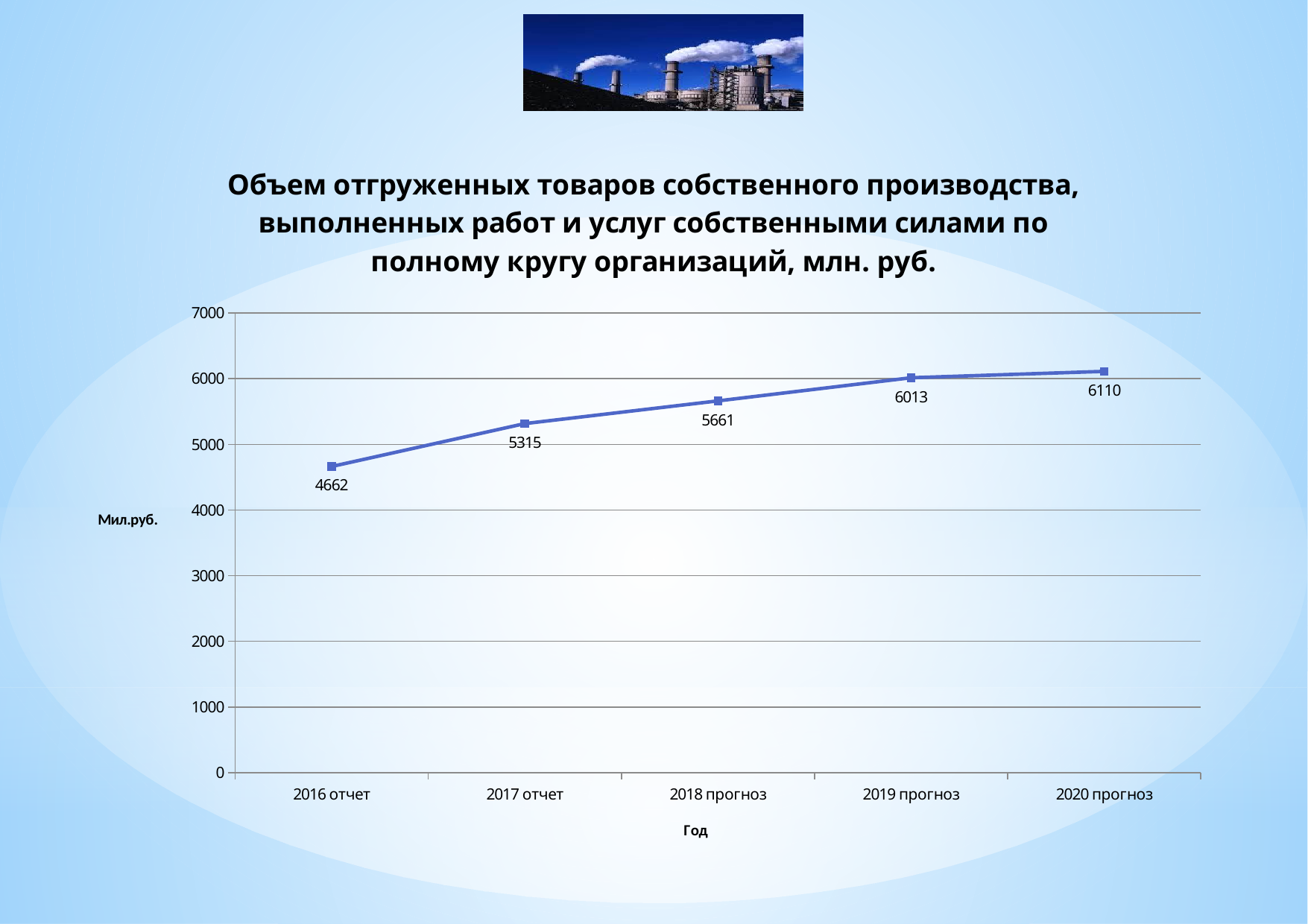
Which year has the highest value? 2020 прогноз Do the values rise or fall from 2016 to 2020? rise What is the value for 2020 прогноз? 6110 What kind of chart is shown on the slide? line chart Which is larger, the value for 2018 прогноз or the value for 2019 прогноз? 2019 прогноз What is the value for 2016 отчет? 4662 What is the difference between the values for 2020 прогноз and 2019 прогноз? 97 How many data points are plotted on the chart? 5 Is the value for 2017 отчет greater or less than 5000? greater What is the value for 2018 прогноз? 5661 Which year has the lowest value? 2016 отчет What is the difference between the values for 2017 отчет and 2016 отчет? 653